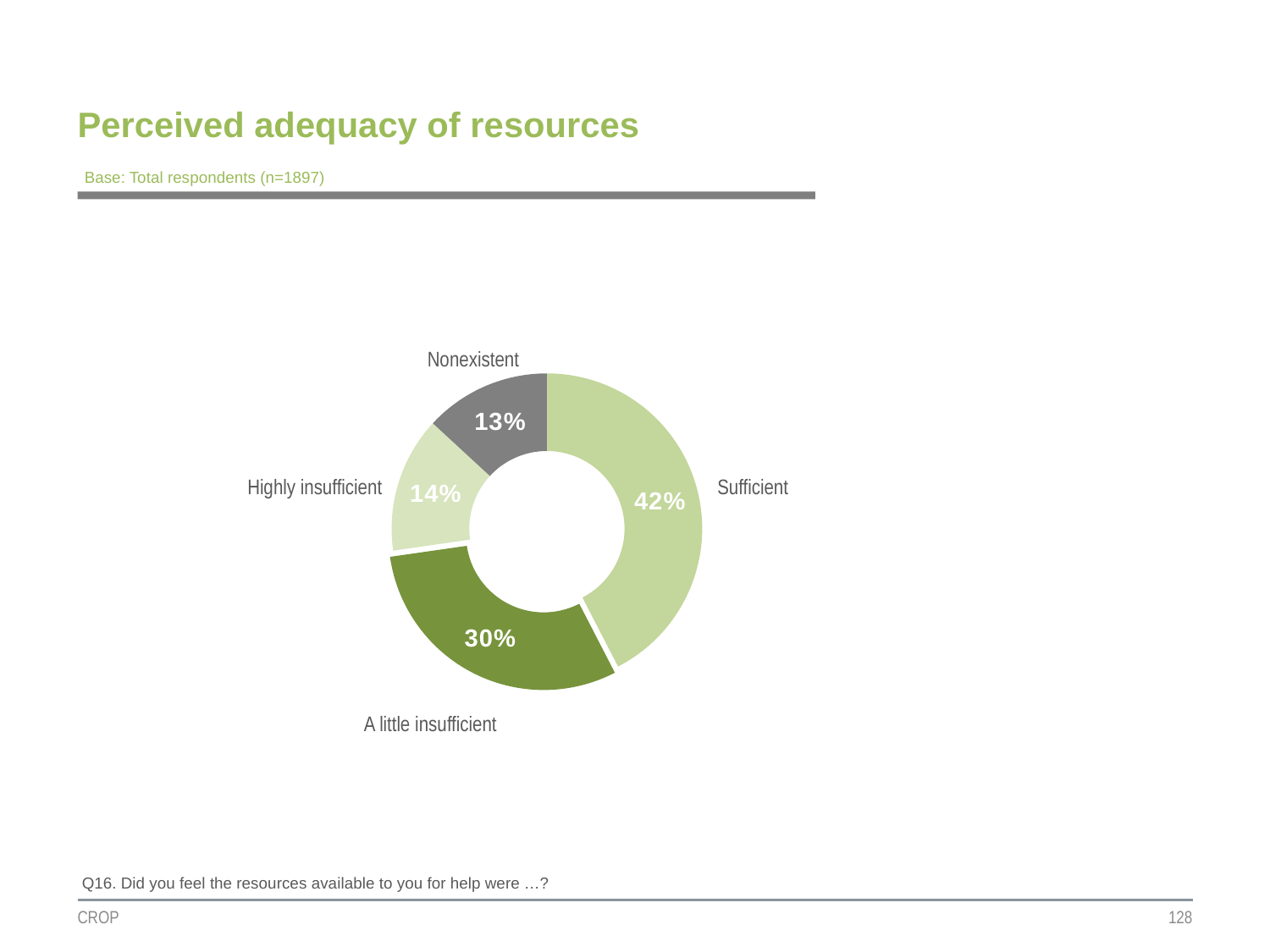
What percentage of respondents said resources were Nonexistent? 13% Which is larger, the share for A little insufficient or the share for Highly insufficient? A little insufficient Which category has the largest share of the chart? Sufficient What kind of chart is shown on the slide? Doughnut chart What percentage of respondents said resources were A little insufficient? 30% How many categories are shown in the chart? 4 What is the difference in percentage points between Sufficient and A little insufficient? 12 What percentage of respondents said resources were Sufficient? 42% What is the difference in percentage points between Highly insufficient and Nonexistent? 1 Which category has the smallest share of the chart? Nonexistent What percentage of respondents said resources were Highly insufficient? 14% What is the title of the slide? Perceived adequacy of resources